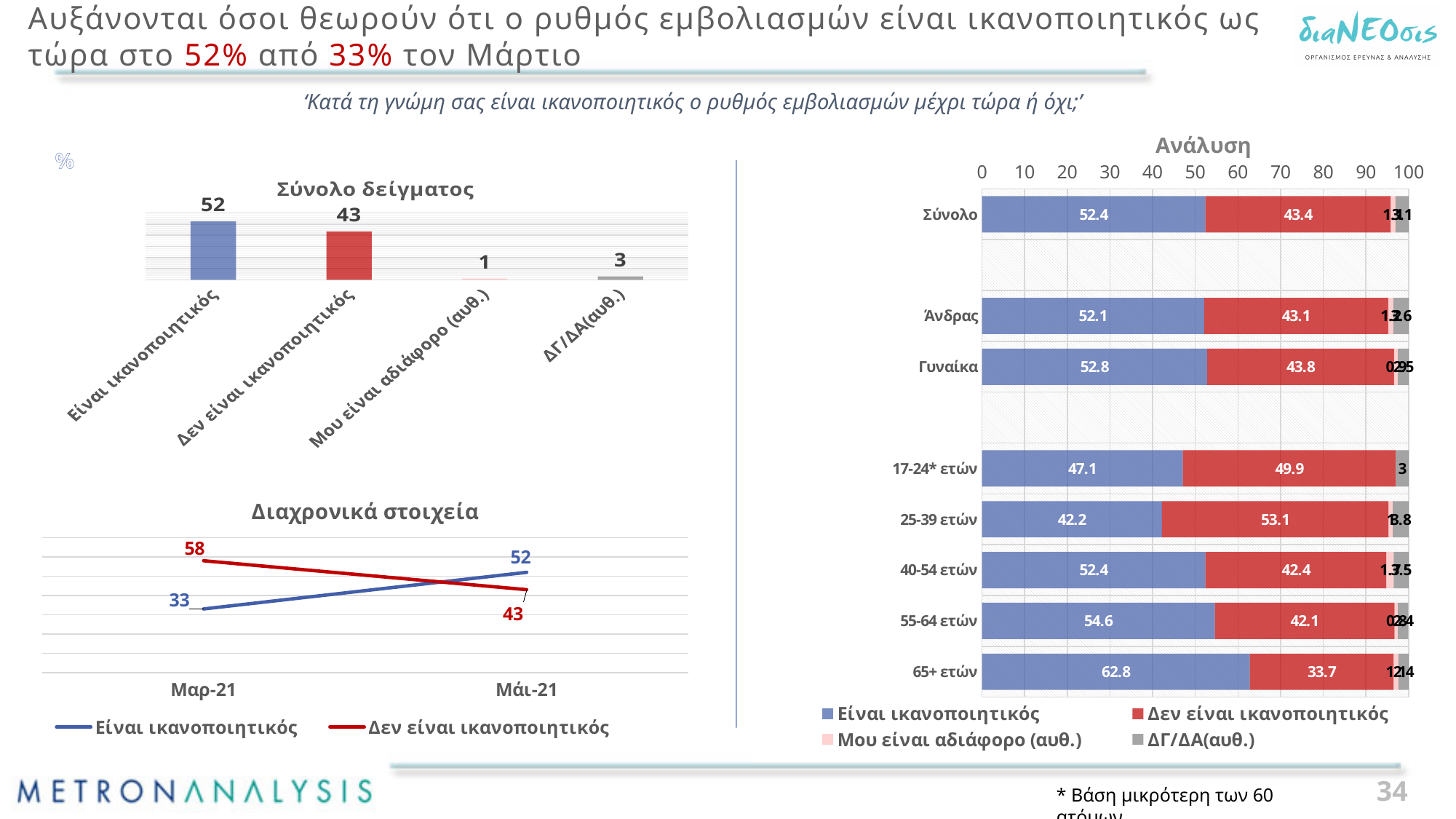
In the 'Ανάλυση' chart, which group has the highest 'Είναι ικανοποιητικός' value? 65+ ετών In the 'Σύνολο δείγματος' chart, which category has the lowest value? Μου είναι αδιάφορο (αυθ.) In the 'Ανάλυση' chart, how many series does the legend list? 4 What kind of chart is the 'Σύνολο δείγματος' chart? Bar chart In the 'Σύνολο δείγματος' chart, what is the difference between 'Είναι ικανοποιητικός' and 'Δεν είναι ικανοποιητικός'? 9 In the 'Διαχρονικά στοιχεία' chart, by how much did 'Δεν είναι ικανοποιητικός' change from Μαρ-21 to Μάι-21? 15 In the 'Διαχρονικά στοιχεία' chart, what is the value for 'Είναι ικανοποιητικός' at Μαρ-21? 33 In the 'Διαχρονικά στοιχεία' chart, does the 'Δεν είναι ικανοποιητικός' line rise or fall from Μαρ-21 to Μάι-21? Fall In the 'Ανάλυση' chart, what is the 'Είναι ικανοποιητικός' value for '65+ ετών'? 62.8 In the 'Σύνολο δείγματος' chart, what is the value for 'Είναι ικανοποιητικός'? 52 In the 'Σύνολο δείγματος' chart, which category has the highest value? Είναι ικανοποιητικός In the 'Σύνολο δείγματος' chart, how many categories are shown? 4